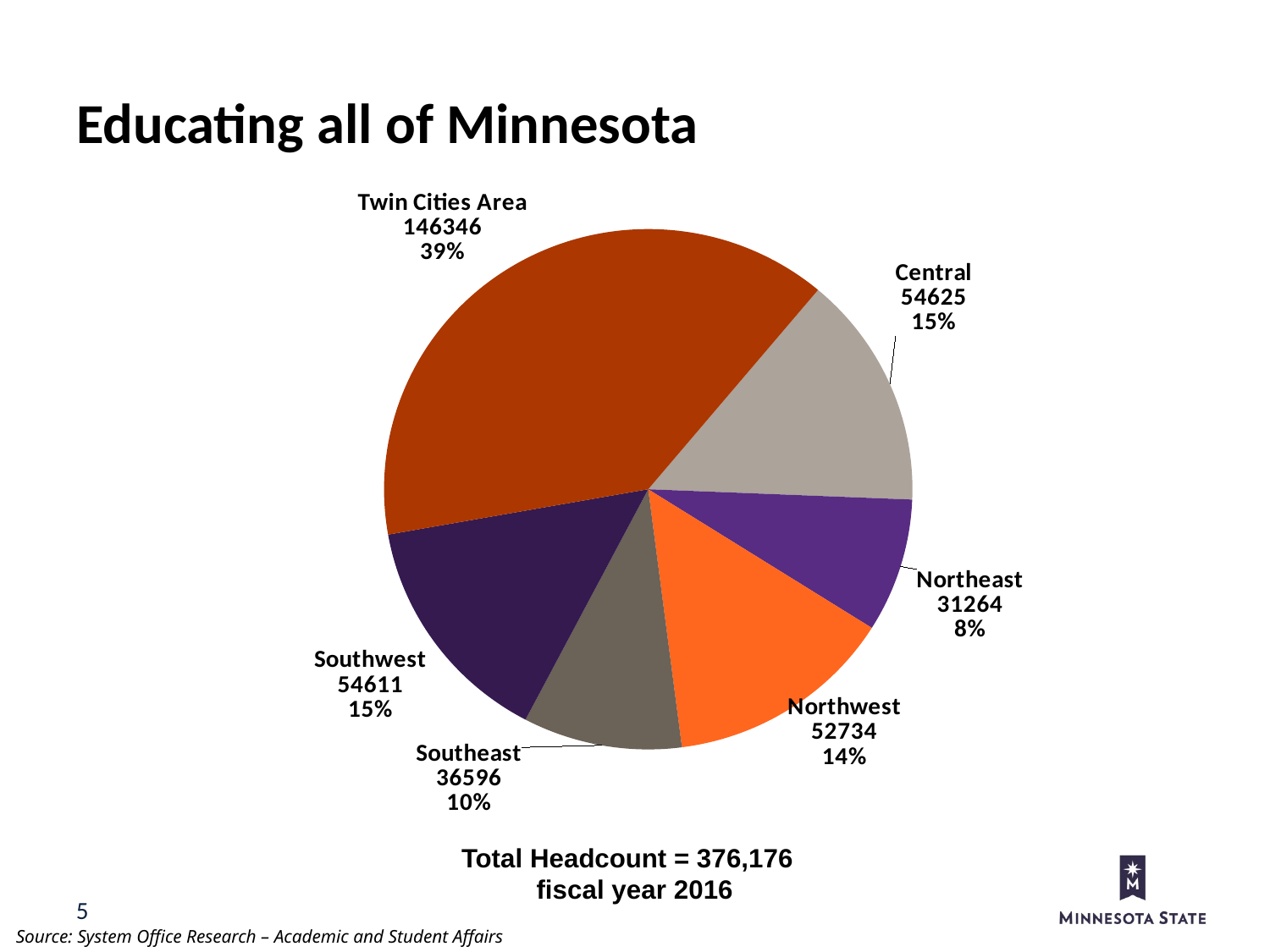
How many regions are shown in the pie chart? 6 What is the difference in headcount between the Twin Cities Area and Central? 91721 What is the headcount for the Northeast region? 31264 What share of the pie does the Northwest region represent? 14% Which has a larger headcount, Northwest or Southeast? Northwest Which region has the largest headcount? Twin Cities Area What total headcount is stated below the chart? 376,176 What share of the pie does the Twin Cities Area represent? 39% Which region has the smallest headcount? Northeast What is the headcount for the Southeast region? 36596 What kind of chart is shown on the slide? pie chart What is the headcount for the Twin Cities Area? 146346